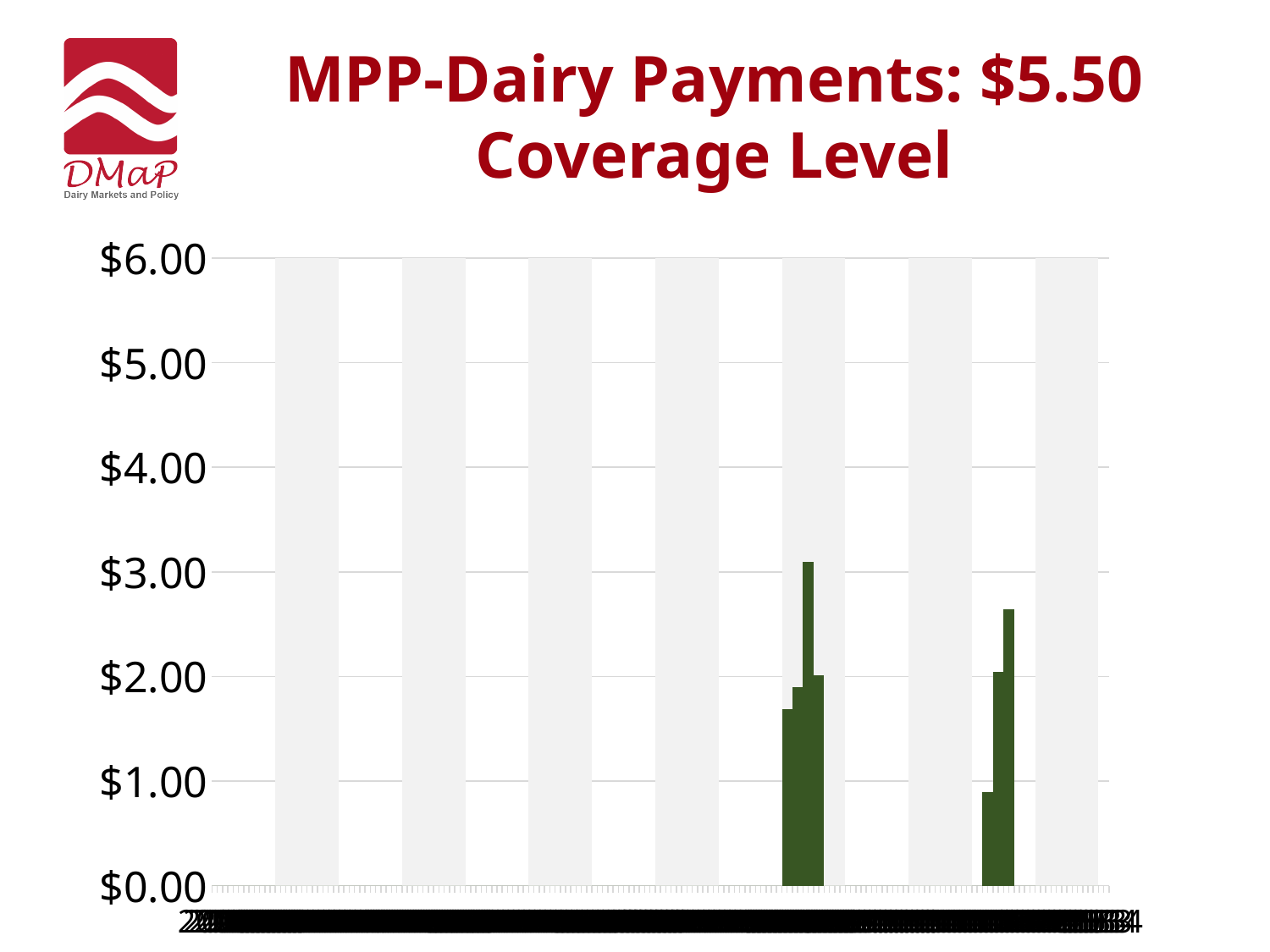
What colour are the bars in the chart? green What is the interval between consecutive tick labels on the y axis? $1.00 Is the tallest bar in the chart greater or less than $2.00? greater What is the title of the chart? MPP-Dairy Payments: $5.50 Coverage Level How many separate groups of non-zero bars appear in the chart? 2 What is the highest value shown on the y axis? $6.00 Is the tallest bar in the left-hand group of bars taller or shorter than the tallest bar in the right-hand group? taller What kind of chart is shown on the slide? bar chart